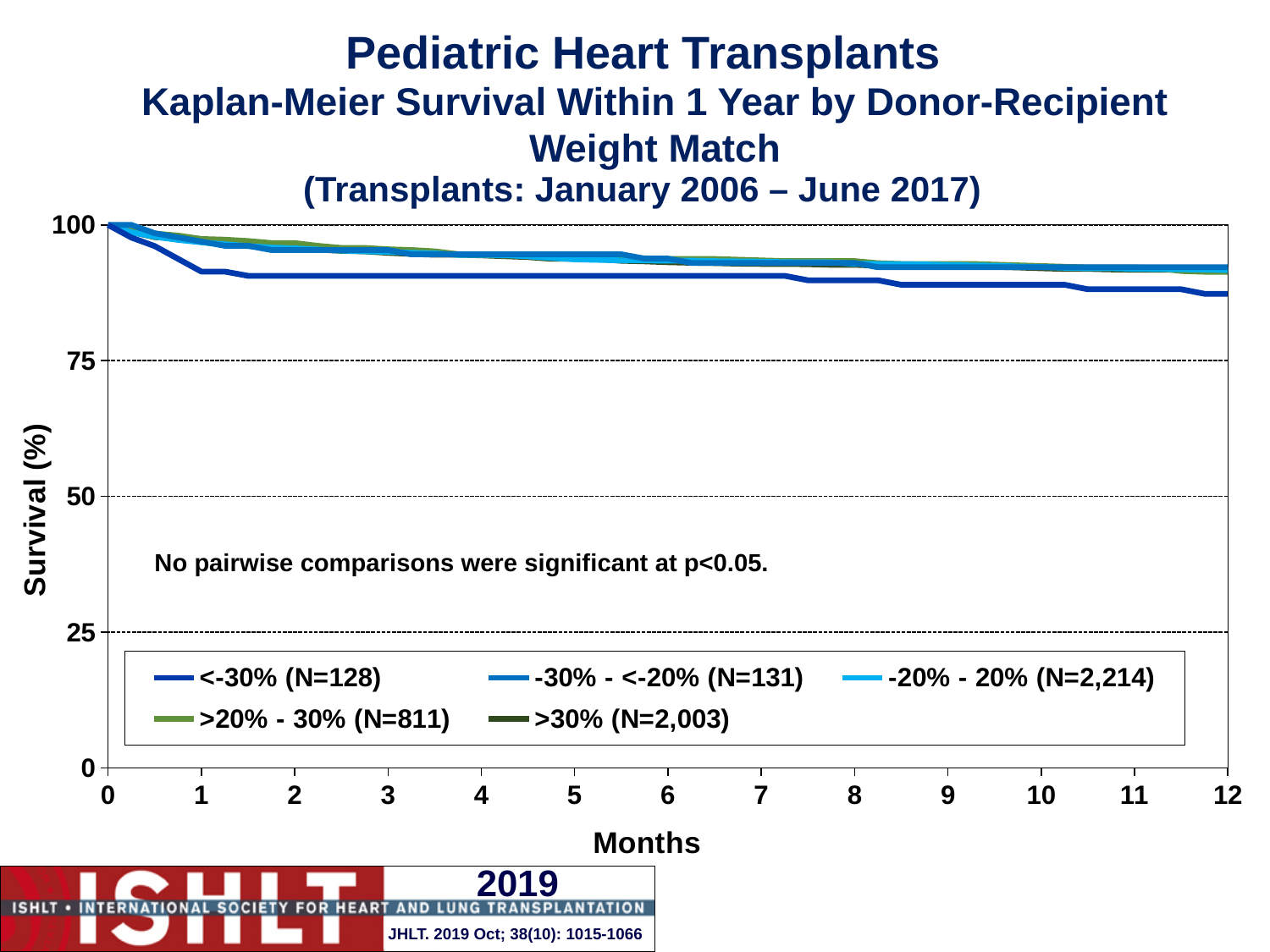
What is the N for the -20% - 20% group shown in the legend? N=2,214 What is the highest value labelled on the Survival (%) axis? 100 Do the survival curves rise or fall as months increase from 0 to 12? fall What kind of chart is shown on the slide? line chart What does the annotation text inside the chart say? No pairwise comparisons were significant at p<0.05. How many tick marks are labelled on the Months axis? 13 At 2 months, which group has higher survival: <-30% or >20% - 30%? >20% - 30% Is the survival value for the >30% group at 6 months greater or less than 75? greater At 12 months, which group has higher survival: <-30% or -20% - 20%? -20% - 20% Is the survival value for the <-30% group at 12 months greater or less than 75? greater How many series does the legend list? 5 Which weight-match group has the lowest survival at 12 months? <-30% (N=128)